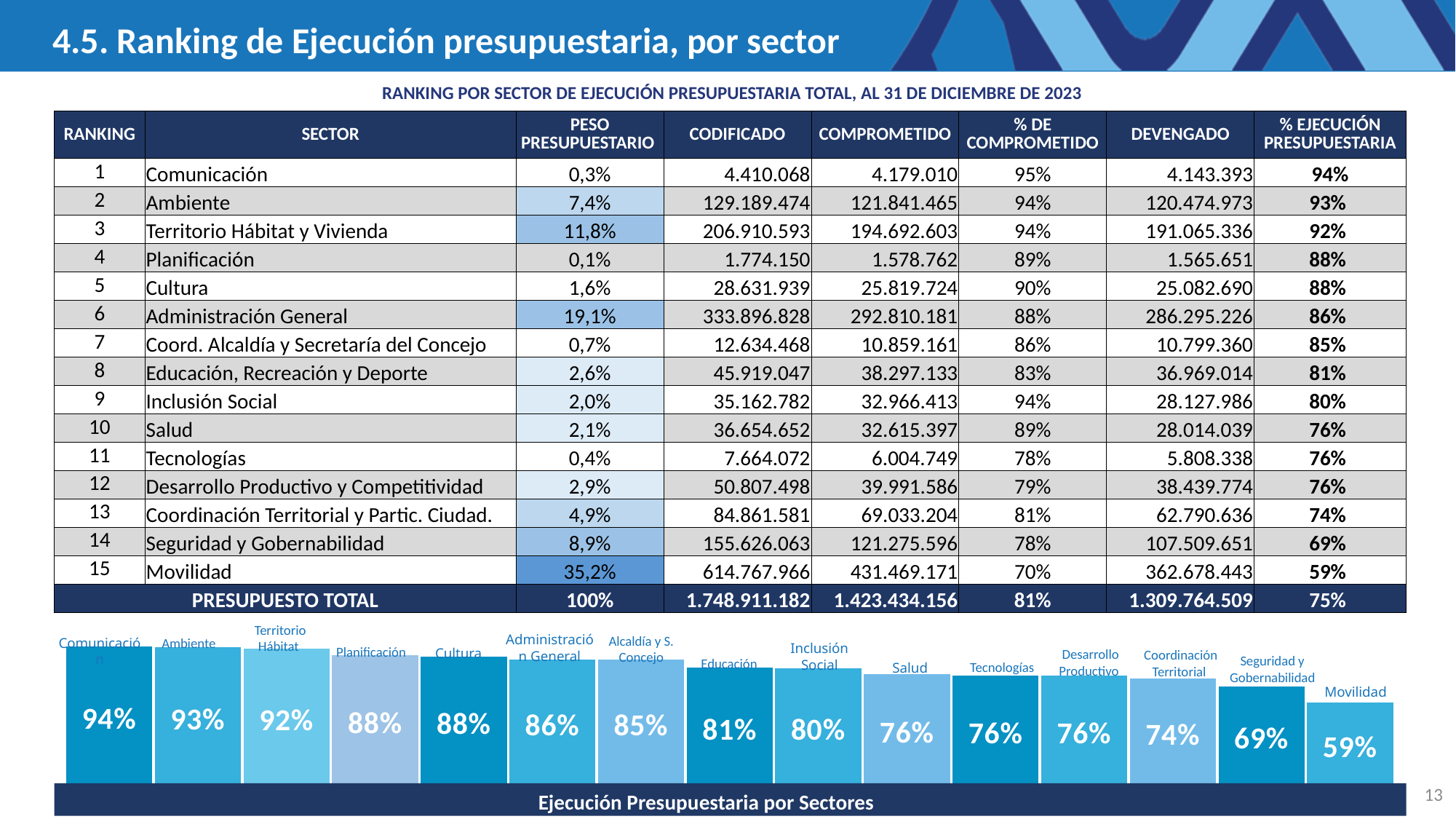
What is the title of the bar chart at the bottom of the slide? Ejecución Presupuestaria por Sectores In the chart 'Ejecución Presupuestaria por Sectores', what is the difference between the values for Educación and Seguridad y Gobernabilidad? 12% In the chart 'Ejecución Presupuestaria por Sectores', which sector has the lowest value? Movilidad In the chart 'Ejecución Presupuestaria por Sectores', what is the value for Ambiente? 93% In the chart 'Ejecución Presupuestaria por Sectores', what is the difference between the values for Comunicación and Movilidad? 35% In the chart 'Ejecución Presupuestaria por Sectores', how many sectors are shown as bars? 15 What kind of chart is 'Ejecución Presupuestaria por Sectores'? Bar chart In the chart 'Ejecución Presupuestaria por Sectores', do the values rise or fall from left to right? Fall In the chart 'Ejecución Presupuestaria por Sectores', which sector has the highest value? Comunicación In the chart 'Ejecución Presupuestaria por Sectores', which is larger, the value for Cultura or the value for Inclusión Social? Cultura In the chart 'Ejecución Presupuestaria por Sectores', what is the value for Salud? 76% In the chart 'Ejecución Presupuestaria por Sectores', what is the value for Movilidad? 59%